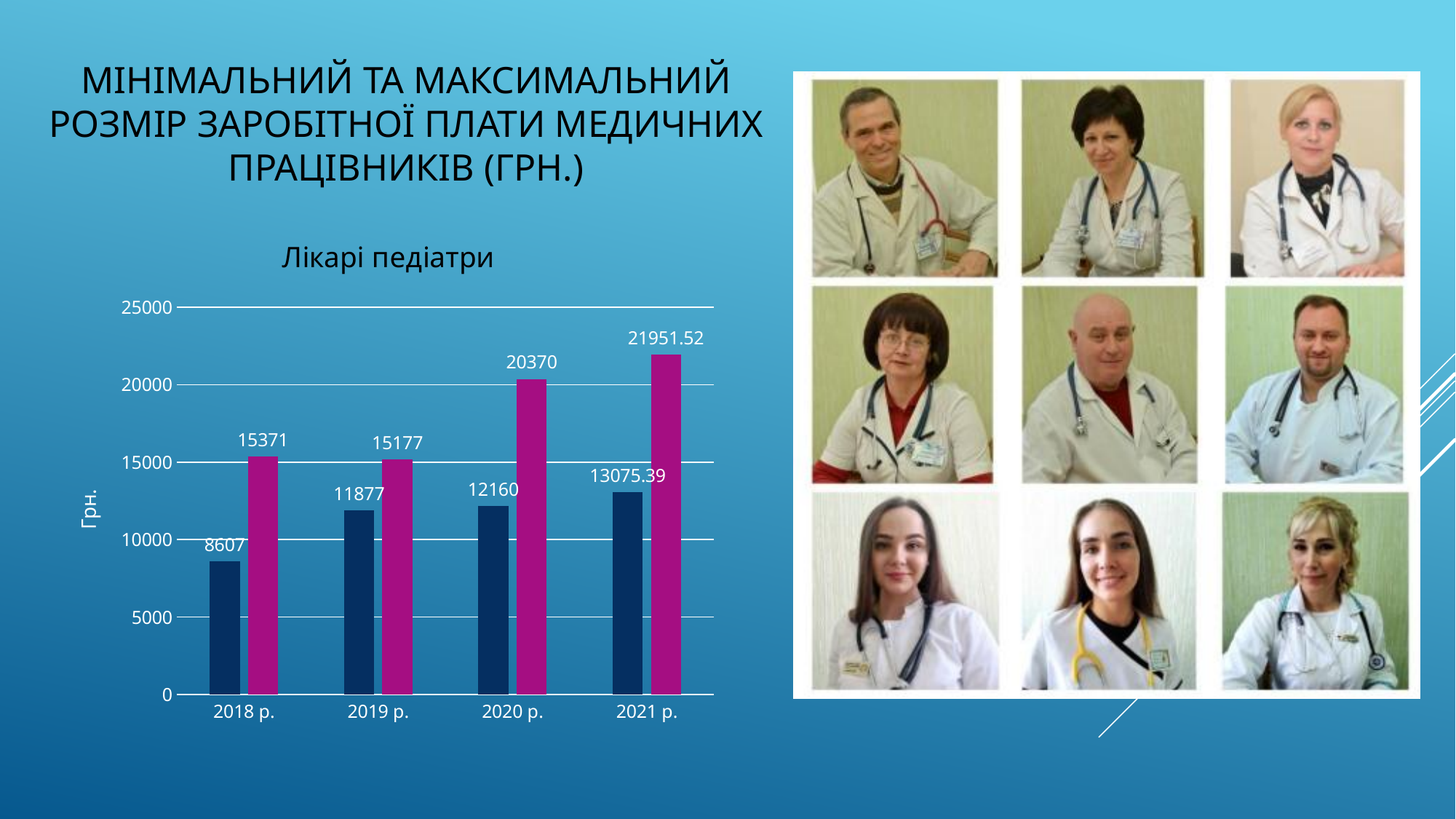
What is the value of the dark blue bar for 2019 р.? 11877 Do the dark blue bars rise or fall from 2018 р. to 2021 р.? rise What kind of chart is shown on the slide? bar chart What is the value of the magenta bar for 2020 р.? 20370 How many years are shown on the x axis of the chart? 4 In which year is the magenta bar the highest? 2021 р. What is the value of the dark blue bar for 2018 р.? 8607 Which year has the larger magenta bar value, 2018 р. or 2019 р.? 2018 р. What is the difference between the magenta bar and the dark blue bar for 2020 р.? 8210 What is the value of the magenta bar for 2021 р.? 21951.52 In which year is the dark blue bar the lowest? 2018 р. What is the difference between the magenta bar and the dark blue bar for 2021 р.? 8876.13